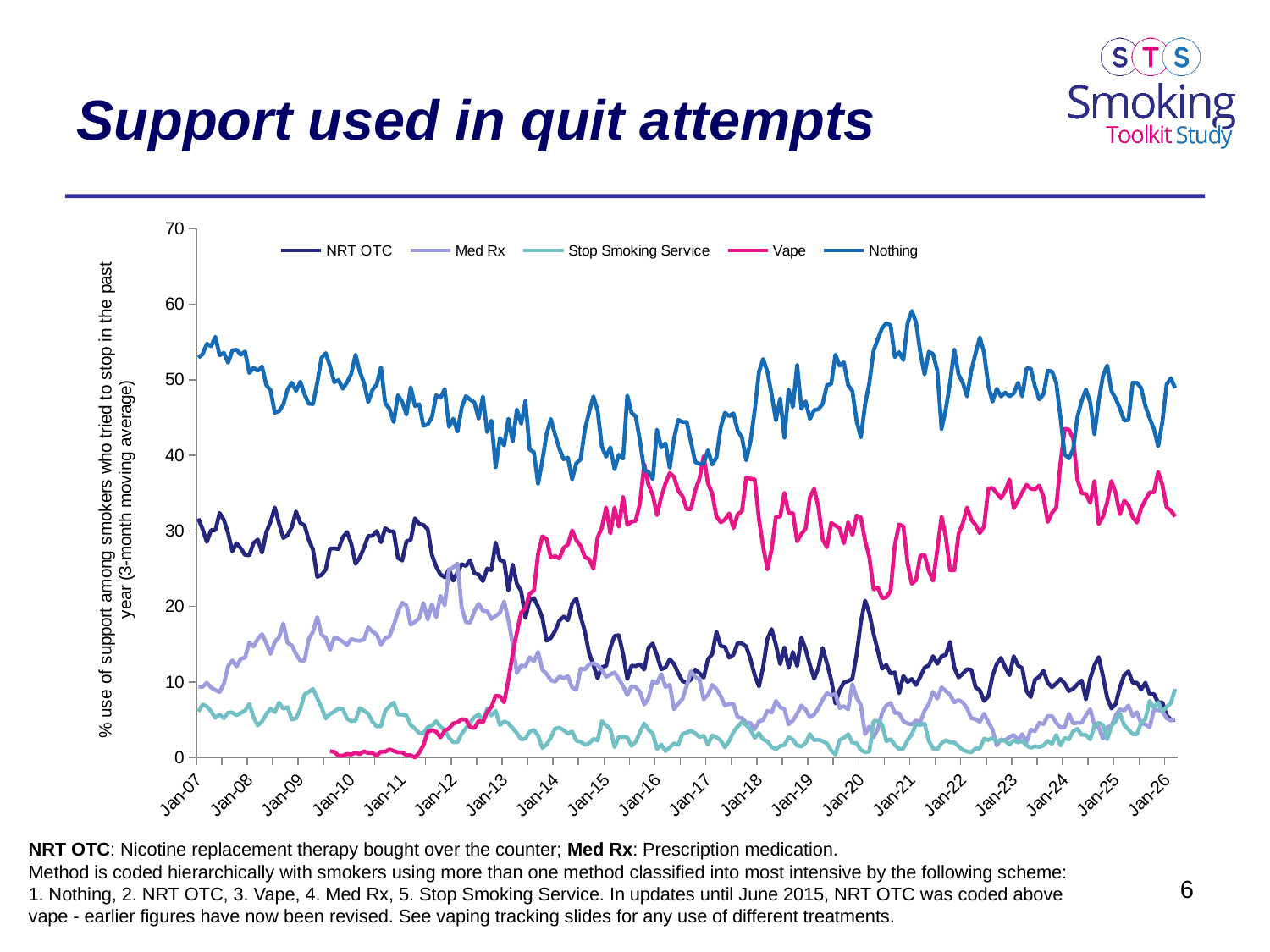
Which series has the highest value at Jan-07? Nothing Which series has the lowest value at Jan-15? Stop Smoking Service How many series does the legend list? 5 Is the value for NRT OTC at Jan-07 greater or less than 20? greater Is the value for Stop Smoking Service at Jan-09 greater or less than 20? less How many year labels are shown on the x axis? 20 What is the title of the chart? Support used in quit attempts Is the value for Nothing at Jan-07 greater or less than 50? greater What kind of chart is shown on the slide? Line chart Which series is plotted in pink? Vape Does the NRT OTC series generally rise or fall from Jan-07 to Jan-26? fall